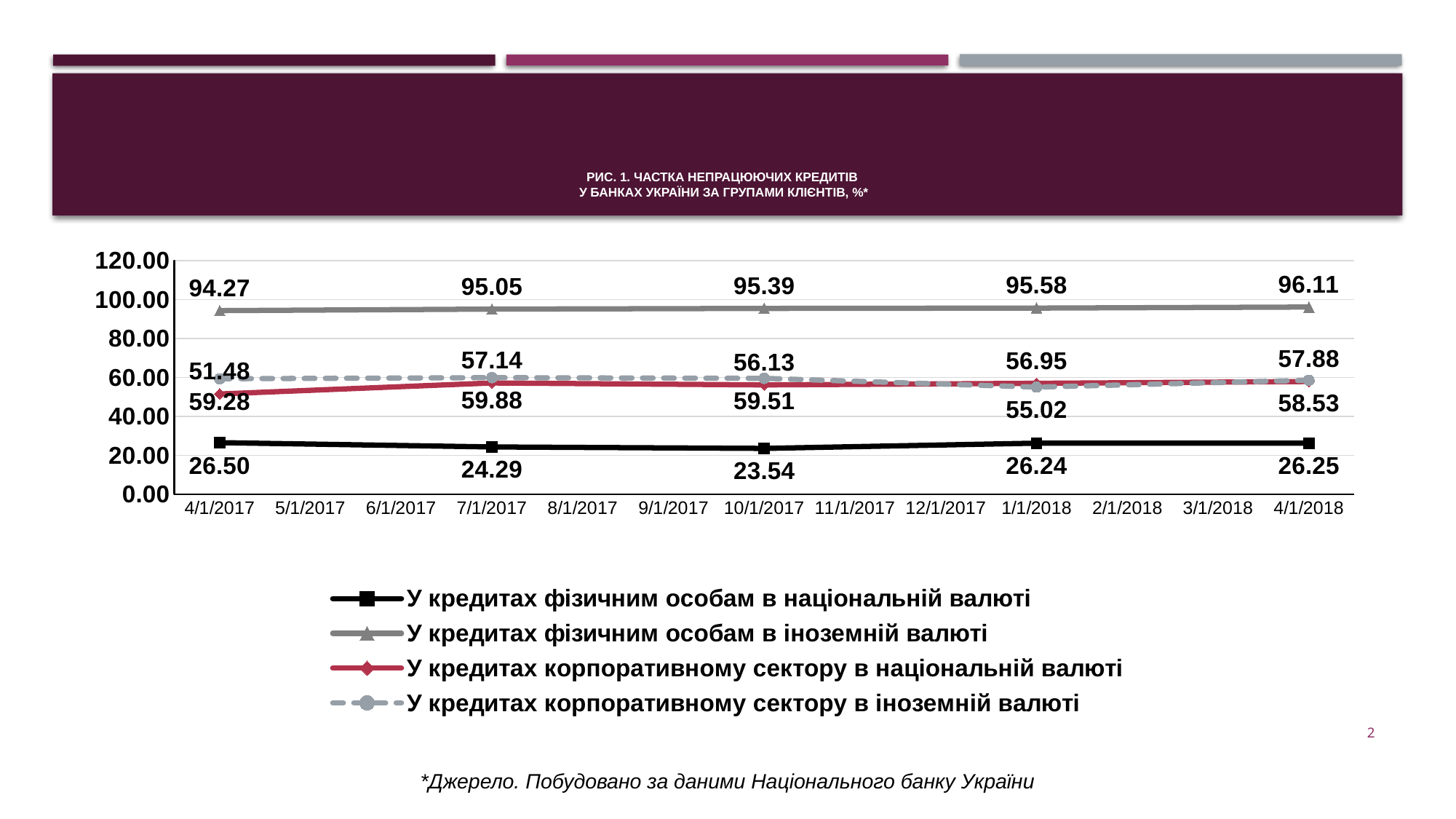
What is the difference between the values for 'У кредитах фізичним особам в іноземній валюті' at 4/1/2018 and 4/1/2017? 1.84 At 1/1/2018, which is larger: 'У кредитах корпоративному сектору в національній валюті' or 'У кредитах корпоративному сектору в іноземній валюті'? У кредитах корпоративному сектору в національній валюті How many series does the legend list? 4 What is the value for 'У кредитах фізичним особам в іноземній валюті' at 4/1/2018? 96.11 What is the value for 'У кредитах корпоративному сектору в національній валюті' at 1/1/2018? 56.95 What kind of chart is shown on the slide? line chart At which date is the value for 'У кредитах фізичним особам в національній валюті' lowest? 10/1/2017 How many data points are plotted for the series 'У кредитах фізичним особам в іноземній валюті'? 5 Does the series 'У кредитах фізичним особам в іноземній валюті' rise or fall from 4/1/2017 to 4/1/2018? rise Is the value for 'У кредитах фізичним особам в національній валюті' at 4/1/2017 greater or less than 40.00? less At which date is the value for 'У кредитах фізичним особам в іноземній валюті' highest? 4/1/2018 What is the value for 'У кредитах фізичним особам в національній валюті' at 10/1/2017? 23.54